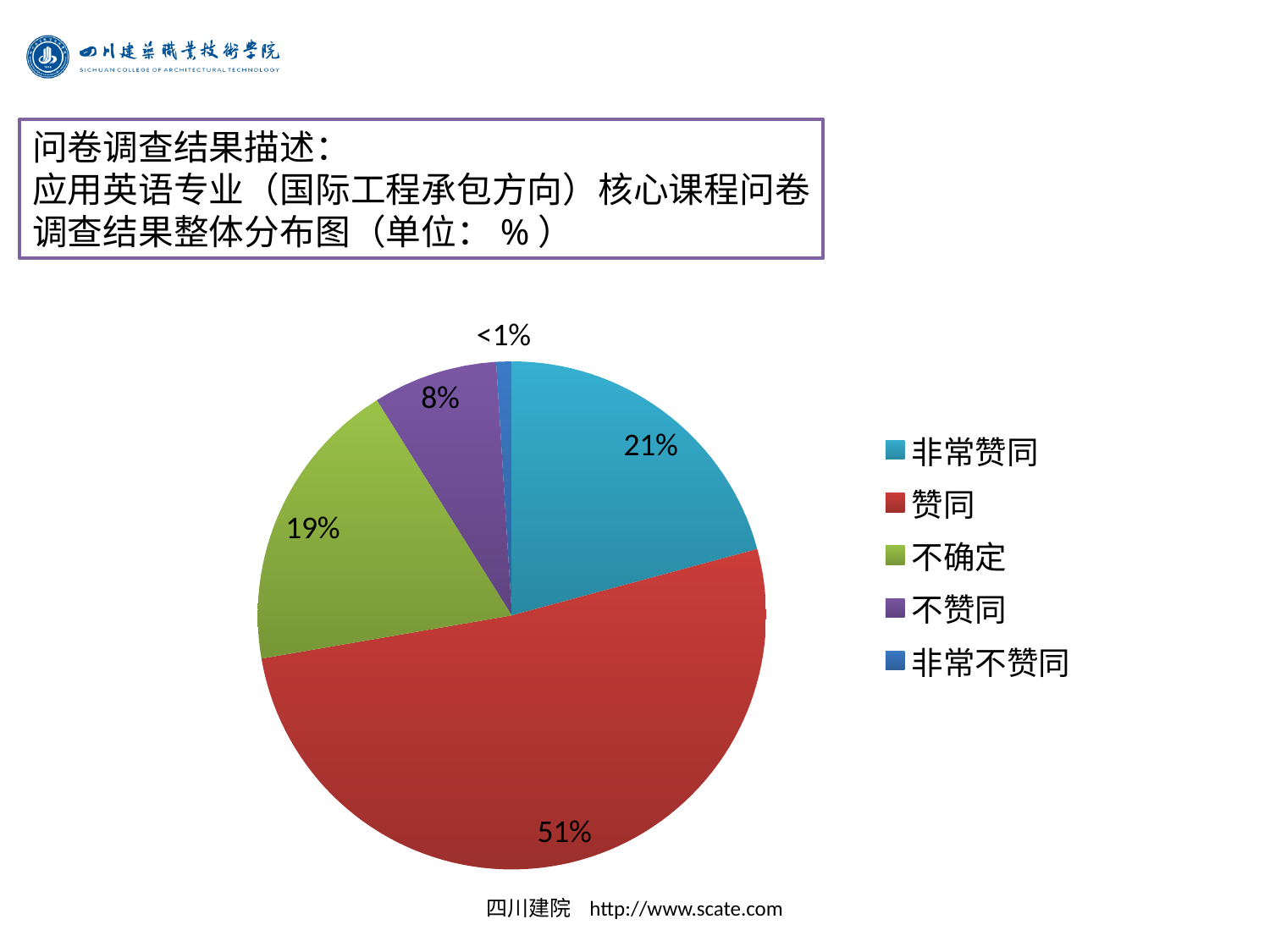
What share of the pie does 赞同 account for? 51% What is the difference between the values for 赞同 and 非常赞同? 30 percentage points What is the value for 不确定? 19% What colour is the 赞同 slice? red Which category has the smallest slice of the pie? 非常不赞同 What is the value for 不赞同? 8% What is the value for 非常赞同? 21% Which category has the largest slice of the pie? 赞同 What label is shown for the 非常不赞同 slice? <1% What type of chart is shown on the slide? pie chart Which is larger, the value for 不确定 or the value for 不赞同? 不确定 How many categories does the legend list? 5